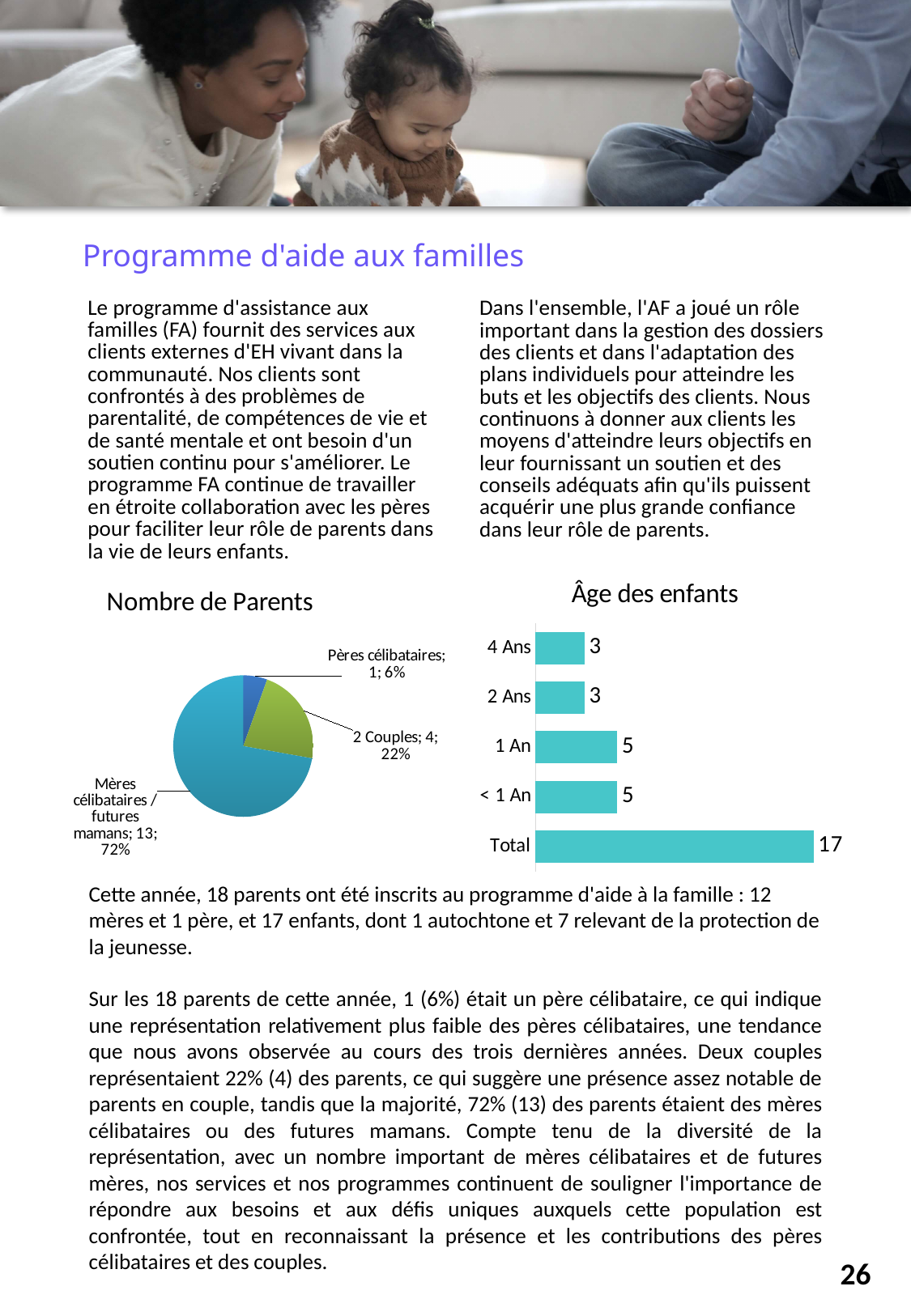
In the 'Âge des enfants' chart, what is the value for '4 Ans'? 3 In the 'Âge des enfants' chart, how many bars are shown? 5 In the 'Nombre de Parents' chart, what share of the pie is 'Mères célibataires / futures mamans'? 72% What kind of chart is 'Nombre de Parents'? Pie chart In the 'Âge des enfants' chart, what is the value for '1 An'? 5 What kind of chart is 'Âge des enfants'? Bar chart In the 'Âge des enfants' chart, what is the value for 'Total'? 17 In the 'Âge des enfants' chart, what is the difference between the values for '< 1 An' and '2 Ans'? 2 In the 'Nombre de Parents' chart, which category has the smallest slice? Pères célibataires In the 'Âge des enfants' chart, which is larger, the value for '1 An' or the value for '4 Ans'? 1 An In the 'Nombre de Parents' chart, how many slices does the pie have? 3 In the 'Nombre de Parents' chart, what is the value for '2 Couples'? 4